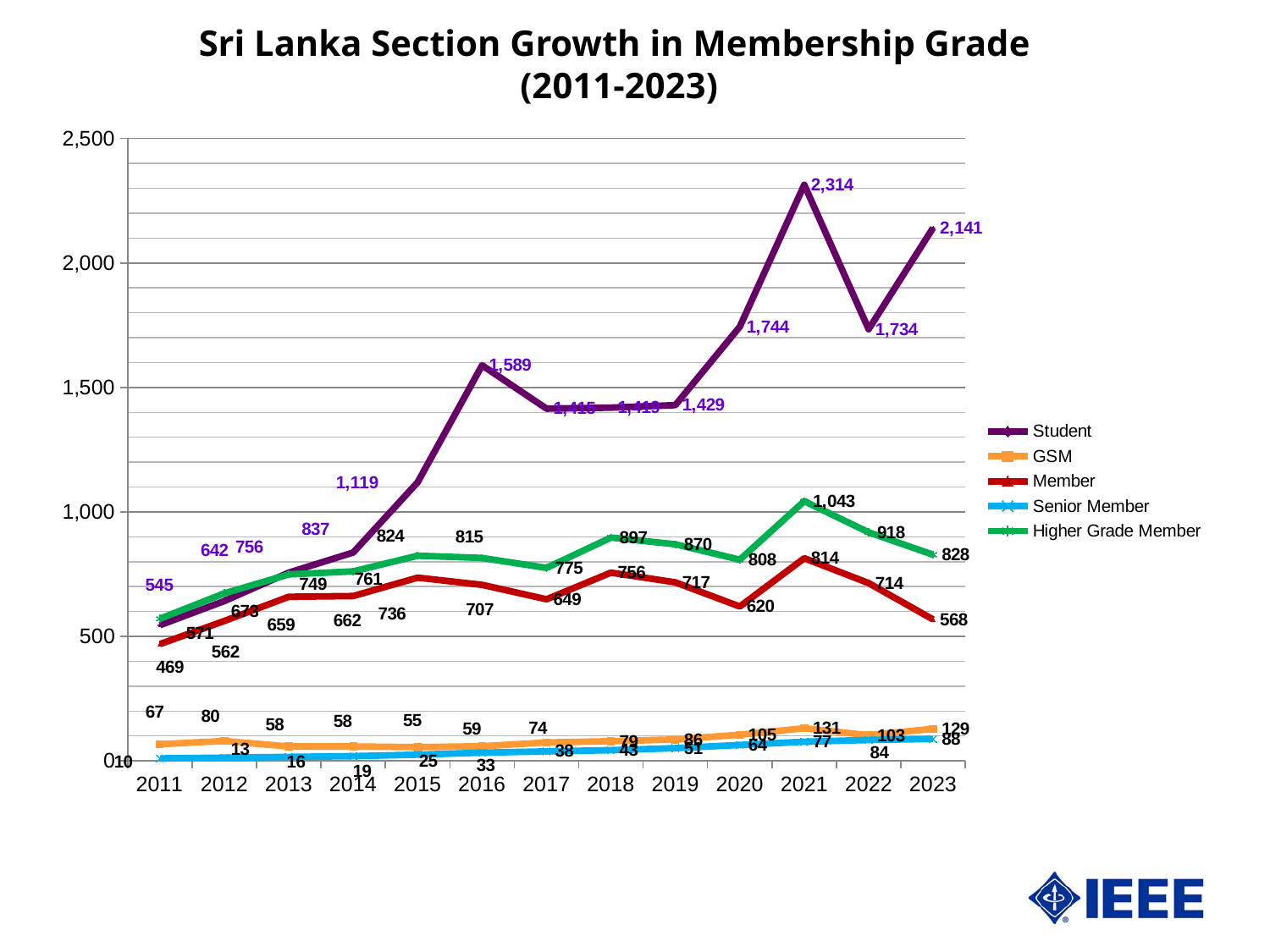
What was the Member value in 2023? 568 In 2018, which was larger: Member or Higher Grade Member? Higher Grade Member By how much did the Student count fall from 2021 to 2022? 580 In which year did the Student series reach its highest value? 2021 How many series does the legend list? 5 What was the Senior Member value in 2011? 10 Does the Senior Member series rise or fall from 2011 to 2023? rise What was the Student membership count in 2021? 2,314 What kind of chart is shown on the slide? line chart How many years are plotted along the x axis? 13 In which year was the Member series at its lowest? 2011 What was the Higher Grade Member value in 2021? 1,043